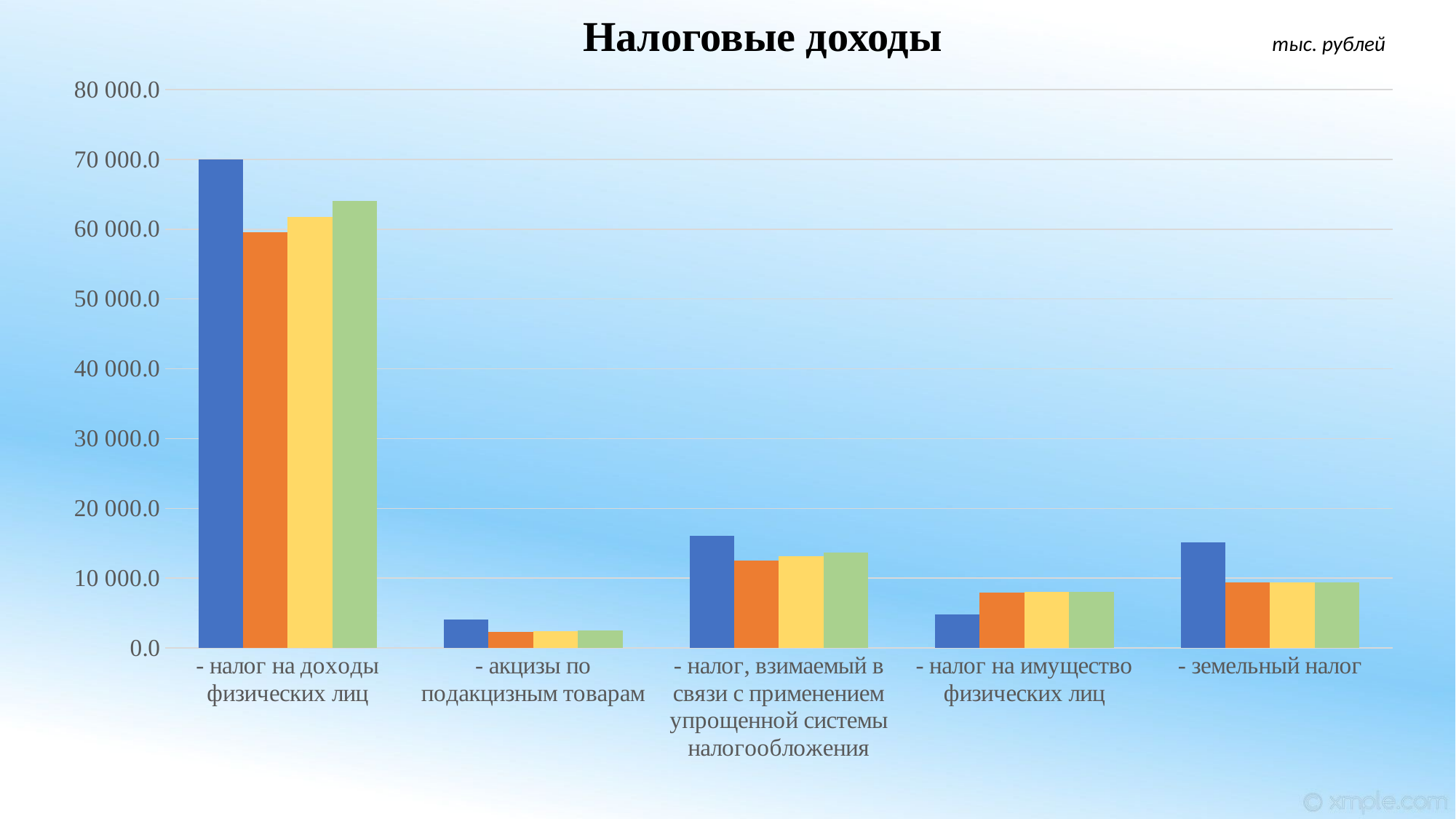
In what units are the values on the chart expressed, according to the note at the top right? тыс. рублей What kind of chart is shown on the slide? bar chart Which category has the tallest bars on the chart? налог на доходы физических лиц How many categories are shown on the x axis of the chart? 5 Is the value of the blue bar for 'налог на доходы физических лиц' greater or less than 60 000.0? greater For 'налог на имущество физических лиц', which is larger: the blue bar or the orange bar? the orange bar Which category has the shortest bars on the chart? акцизы по подакцизным товарам For 'налог на доходы физических лиц', which is larger: the blue bar or the orange bar? the blue bar Is the value of the blue bar for 'акцизы по подакцизным товарам' greater or less than 10 000.0? less What is the title of the chart? Налоговые доходы Is the value of the blue bar for 'земельный налог' greater or less than 10 000.0? greater How many bars are plotted for each category? 4